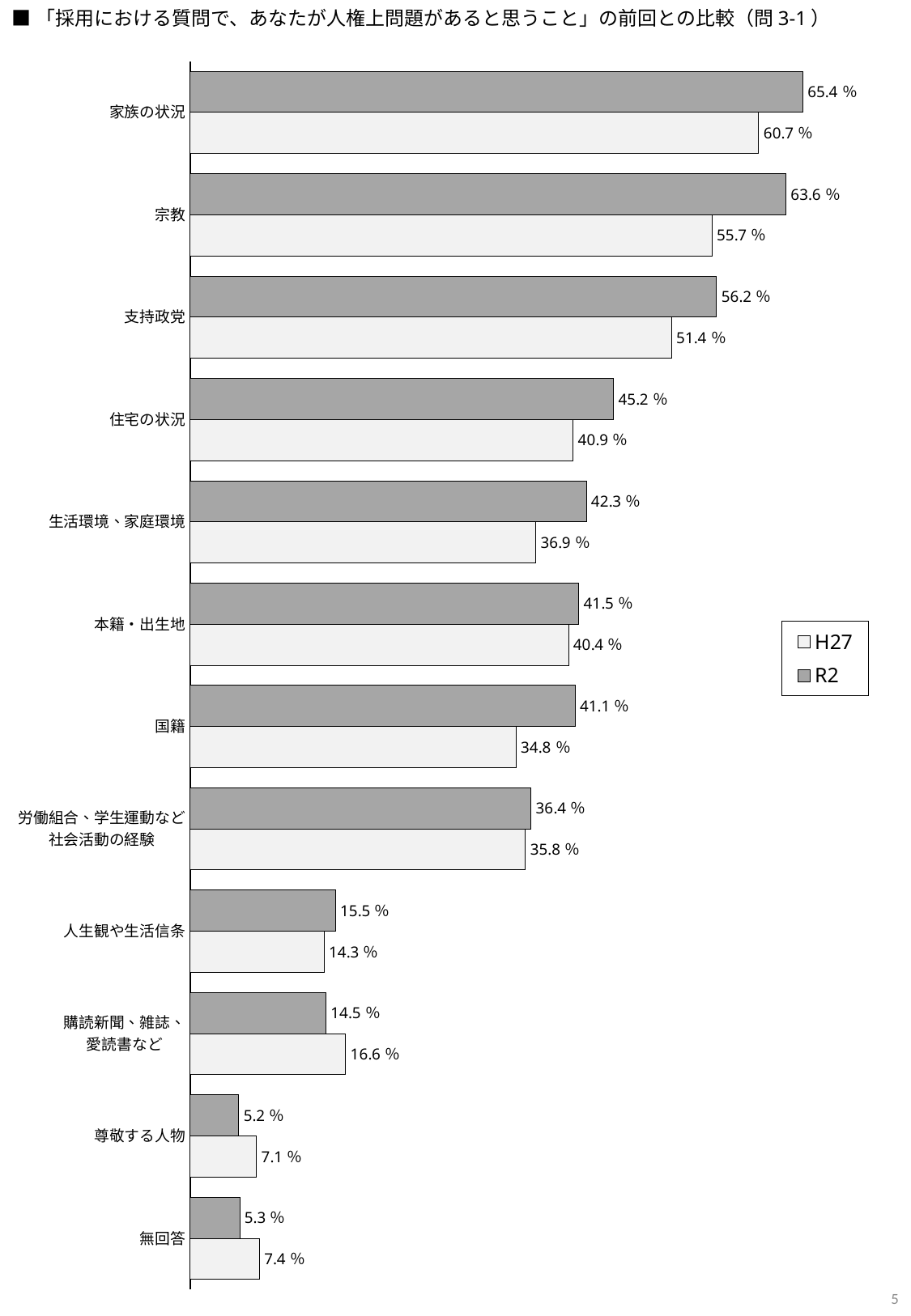
Which category has the lowest H27 value? 尊敬する人物 What is the H27 value for 宗教? 55.7 % What kind of chart is shown on the slide? Bar chart Which category has the highest R2 value? 家族の状況 What is the difference between the R2 and H27 values for 国籍? 6.3 % How many categories are shown on the chart? 12 What is the H27 value for 国籍? 34.8 % How many series does the legend list? 2 What is the difference between the R2 and H27 values for 宗教? 7.9 % For 購読新聞、雑誌、愛読書など, which is larger, the H27 value or the R2 value? H27 What is the R2 value for 家族の状況? 65.4 % For 住宅の状況, which is larger, the H27 value or the R2 value? R2